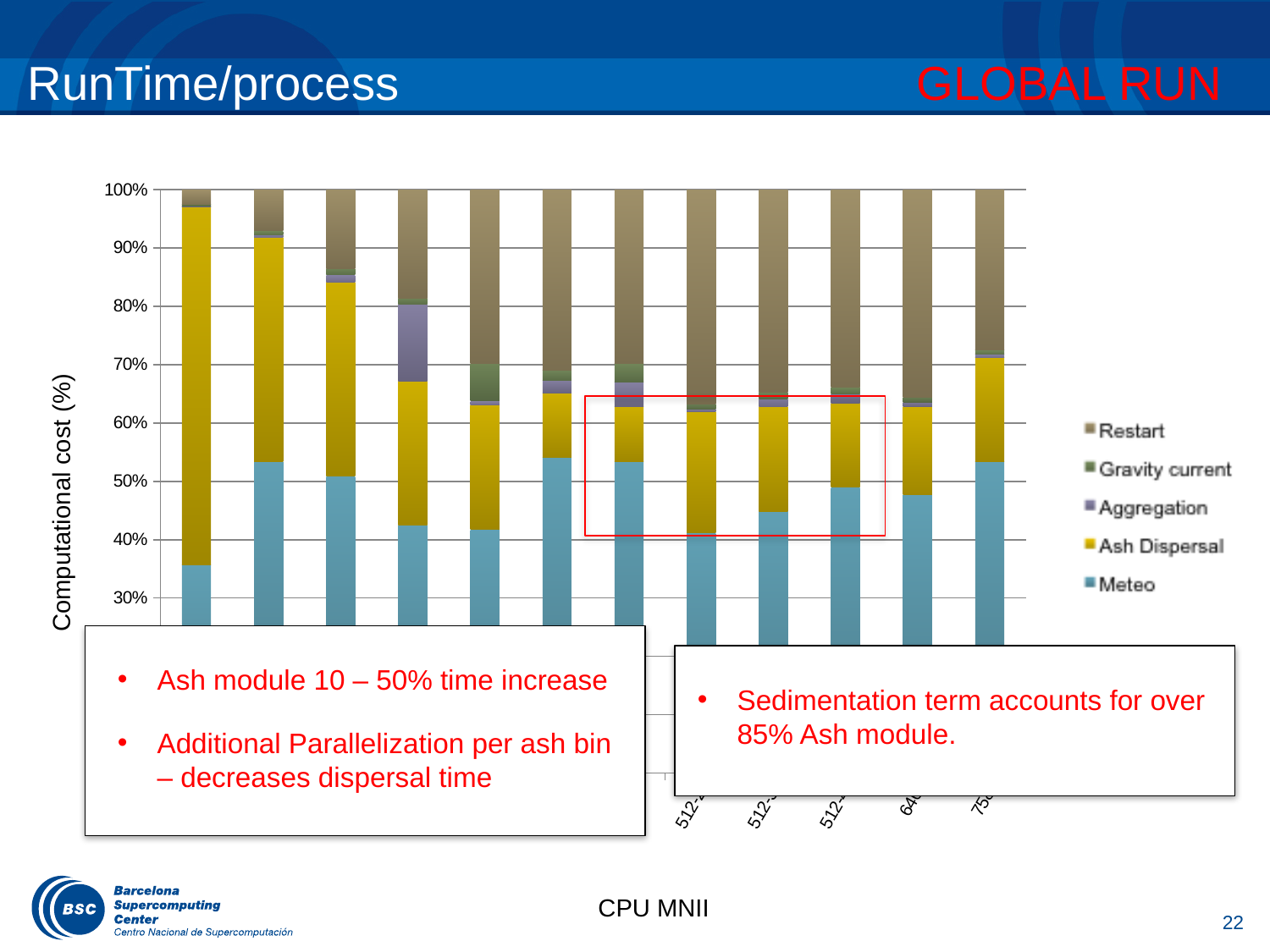
Which series is listed at the bottom of the chart legend? Meteo In the leftmost bar, is the top of the Meteo segment greater or less than 40%? less In the fourth bar from the left, is the top of the Meteo segment greater or less than 50%? less Does the Ash Dispersal share generally rise or fall moving from the leftmost bar to the rightmost bar? Fall Which bar has the larger Meteo segment, the leftmost bar or the second bar from the left? The second bar from the left In the leftmost bar, is the top of the Ash Dispersal segment greater or less than 90%? greater How many series does the chart legend list? 5 How many bars are plotted in the chart? 12 What is the label of the vertical axis of the chart? Computational cost (%) What kind of chart is shown on the slide? Stacked bar chart